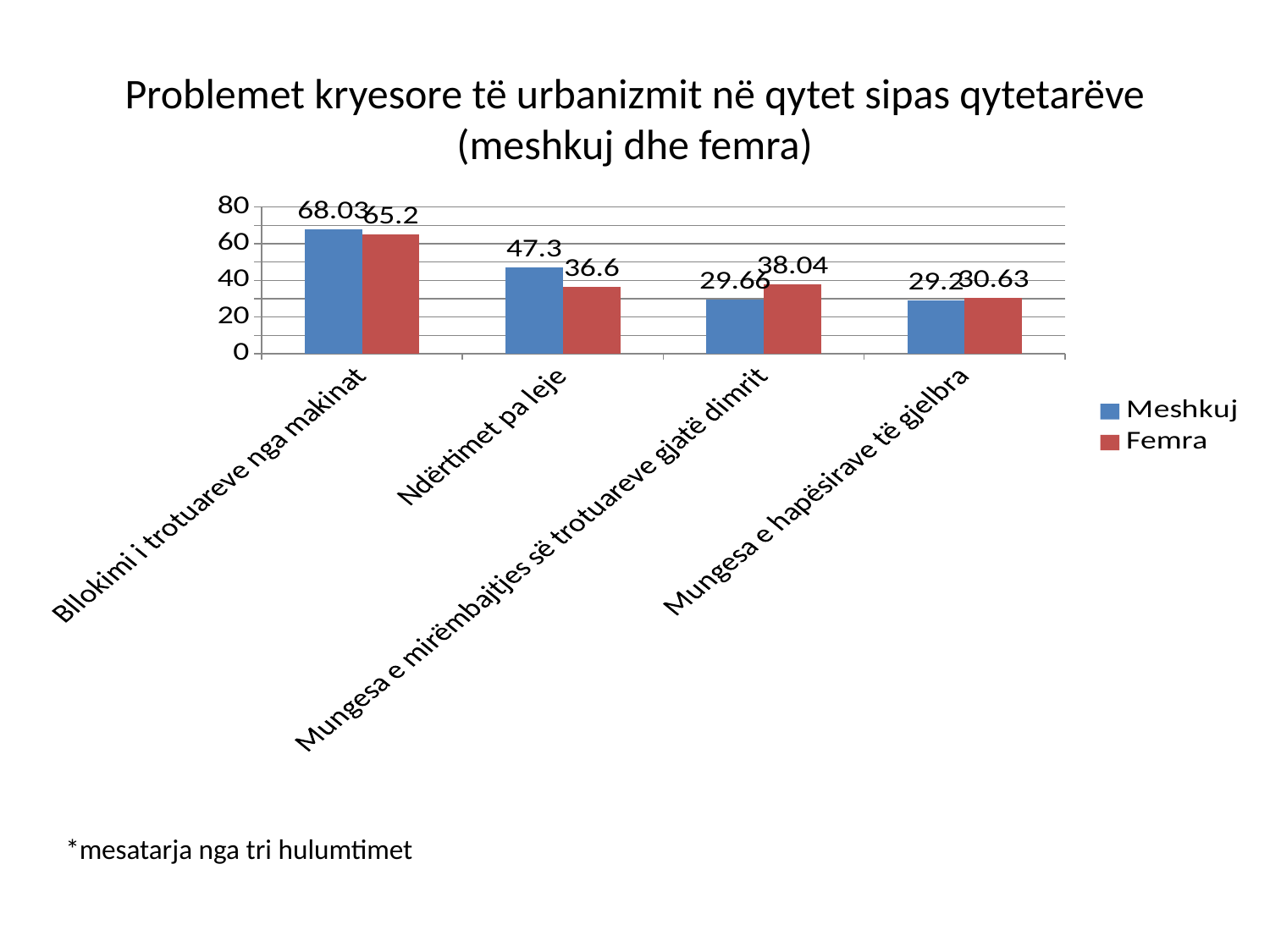
What is the Meshkuj value for Bllokimi i trotuareve nga makinat? 68.03 How many categories are shown on the x axis? 4 What is the difference between the Meshkuj and Femra values for Ndërtimet pa leje? 10.7 What is the Femra value for Mungesa e mirëmbajtjes së trotuareve gjatë dimrit? 38.04 Which category has the highest Meshkuj value? Bllokimi i trotuareve nga makinat What is the Femra value for Mungesa e hapësirave të gjelbra? 30.63 Which category has the lowest Femra value? Mungesa e hapësirave të gjelbra For Mungesa e mirëmbajtjes së trotuareve gjatë dimrit, which is larger, the Meshkuj or the Femra value? Femra Is the Meshkuj value for Mungesa e hapësirave të gjelbra greater or less than 40? less How many series does the legend list? 2 What is the Femra value for Ndërtimet pa leje? 36.6 What kind of chart is shown on the slide? bar chart